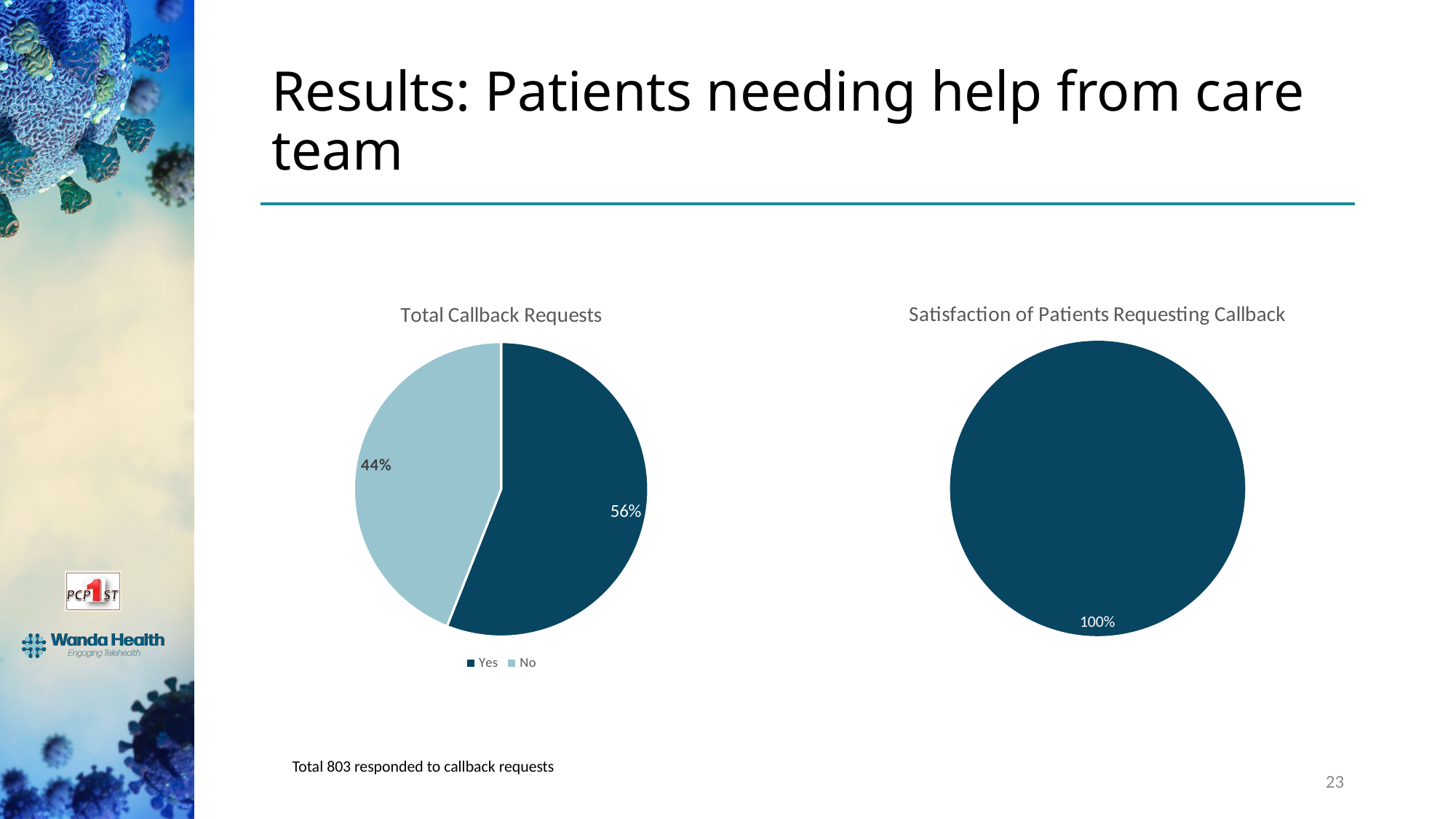
In the 'Total Callback Requests' chart, what share of the pie is labelled 'No'? 44% In the 'Total Callback Requests' chart, what is the difference in percentage points between the 'Yes' and 'No' slices? 12% What kind of chart is 'Total Callback Requests'? Pie chart In the 'Total Callback Requests' chart, which colour represents 'No' in the legend? Light blue In the 'Satisfaction of Patients Requesting Callback' chart, what percentage is shown on the pie? 100% How many slices does the 'Total Callback Requests' pie have? 2 In the 'Total Callback Requests' chart, what share of the pie is labelled 'Yes'? 56% In the 'Total Callback Requests' chart, which category has the smallest slice? No In the 'Total Callback Requests' chart, which slice is larger, 'Yes' or 'No'? Yes What kind of chart is 'Satisfaction of Patients Requesting Callback'? Pie chart What is the title of the chart on the right side of the slide? Satisfaction of Patients Requesting Callback How many entries does the legend of the 'Total Callback Requests' chart list? 2